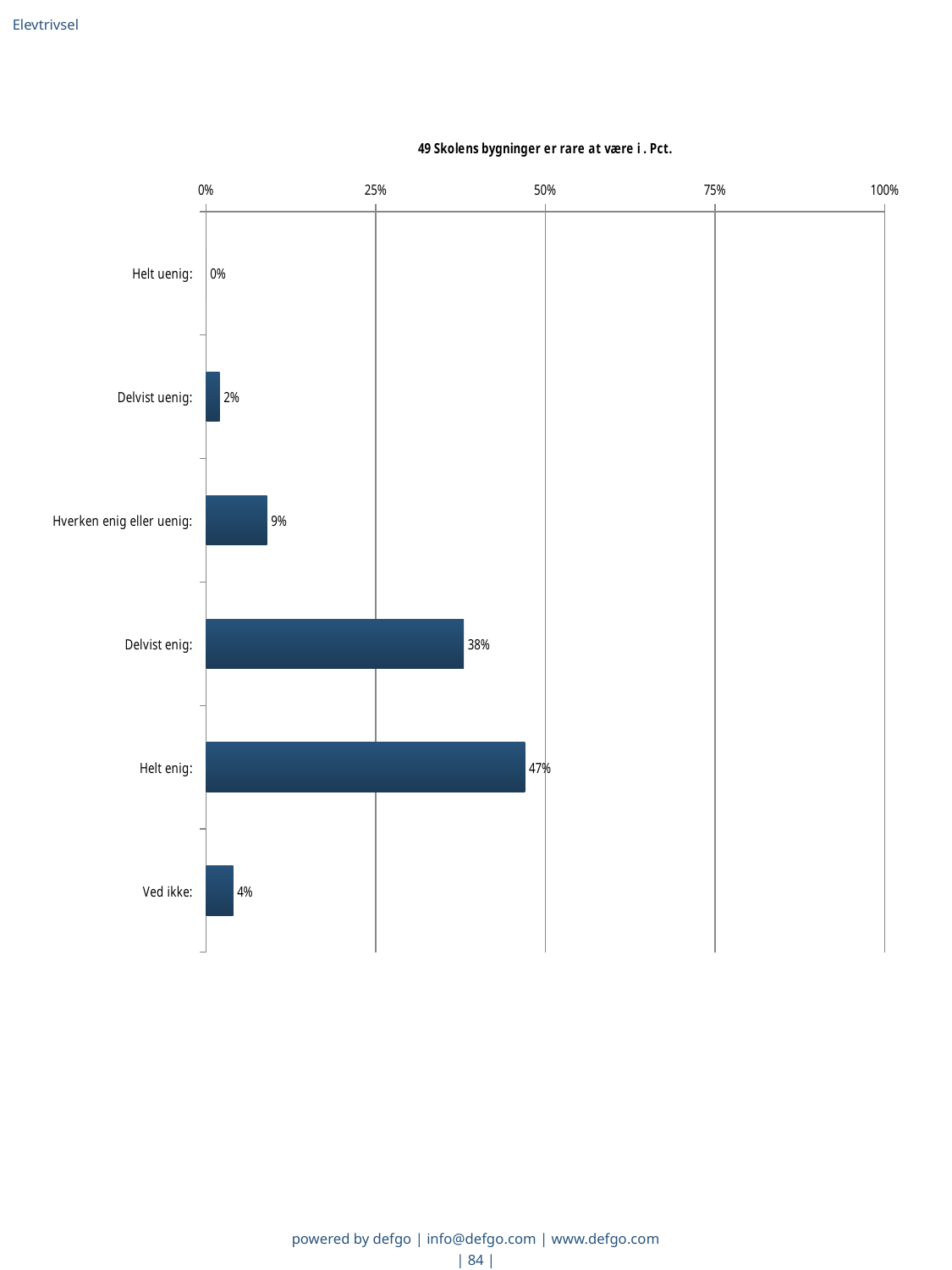
How many categories are shown in the chart? 6 What is the title of the chart? 49 Skolens bygninger er rare at være i . Pct. Is the value for "Helt enig" greater or less than 50%? less Which category has the lowest value? Helt uenig What is the difference between the values for "Helt enig" and "Delvist enig"? 9% What is the value for "Delvist enig"? 38% Which is larger, the value for "Hverken enig eller uenig" or the value for "Ved ikke"? Hverken enig eller uenig Which category has the highest value? Helt enig What is the value for "Helt enig"? 47% What is the value for "Hverken enig eller uenig"? 9% What is the value for "Ved ikke"? 4% What kind of chart is shown on the slide? bar chart